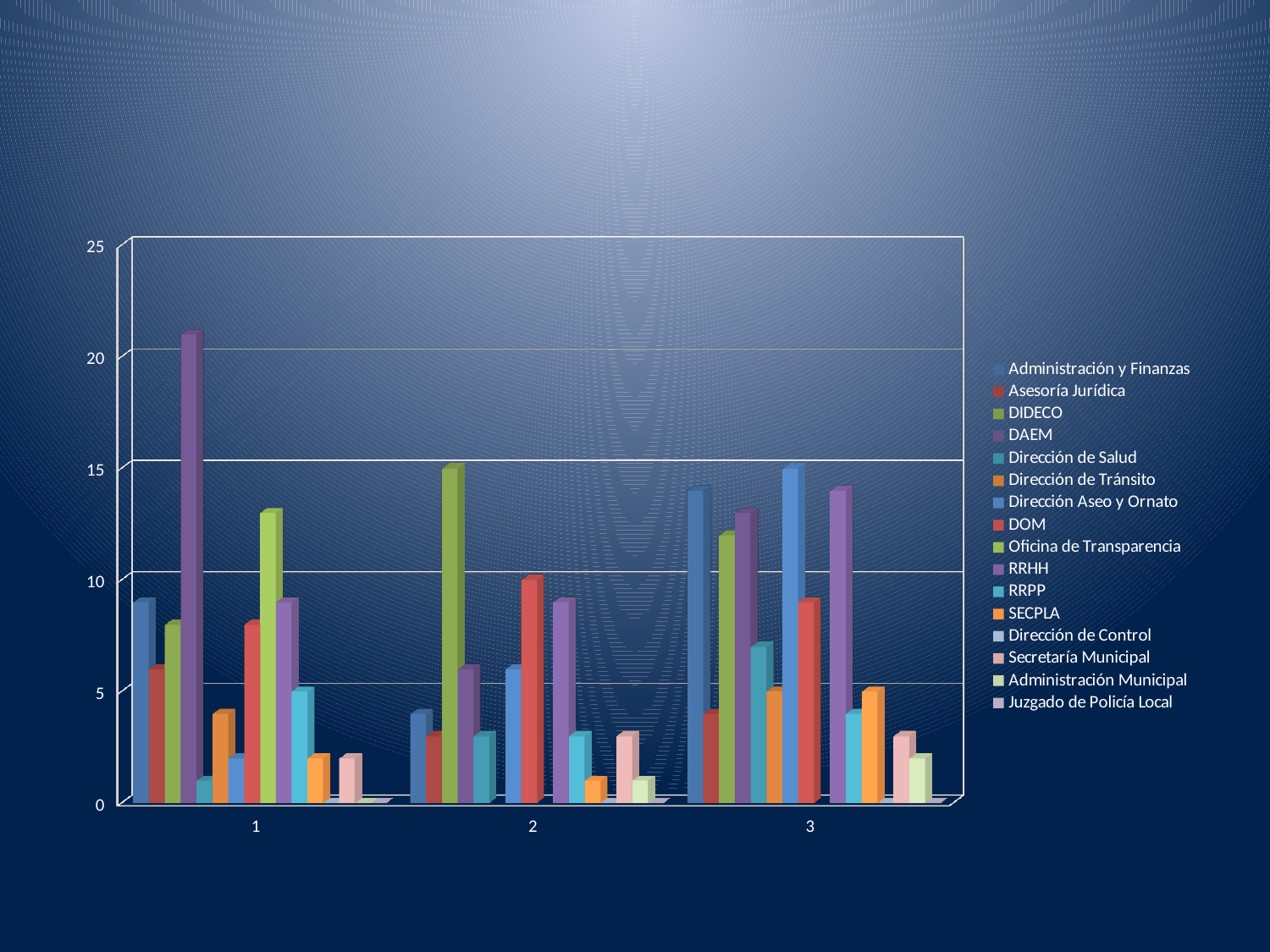
Is the value for Dirección de Salud in category 1 greater or less than 5? less Is the value for DAEM in category 2 greater or less than 5? greater How many series does the legend list? 16 Which series has the highest value in category 2? DIDECO How many categories are shown on the x axis? 3 What is the first series listed in the legend? Administración y Finanzas Which series has the highest value in category 1? DAEM Is the value for Oficina de Transparencia in category 1 greater or less than 10? greater Which is larger, the value for DAEM in category 1 or the value for DAEM in category 2? DAEM in category 1 Which is larger, the value for DIDECO in category 1 or the value for DIDECO in category 2? DIDECO in category 2 What kind of chart is shown on the slide? bar chart